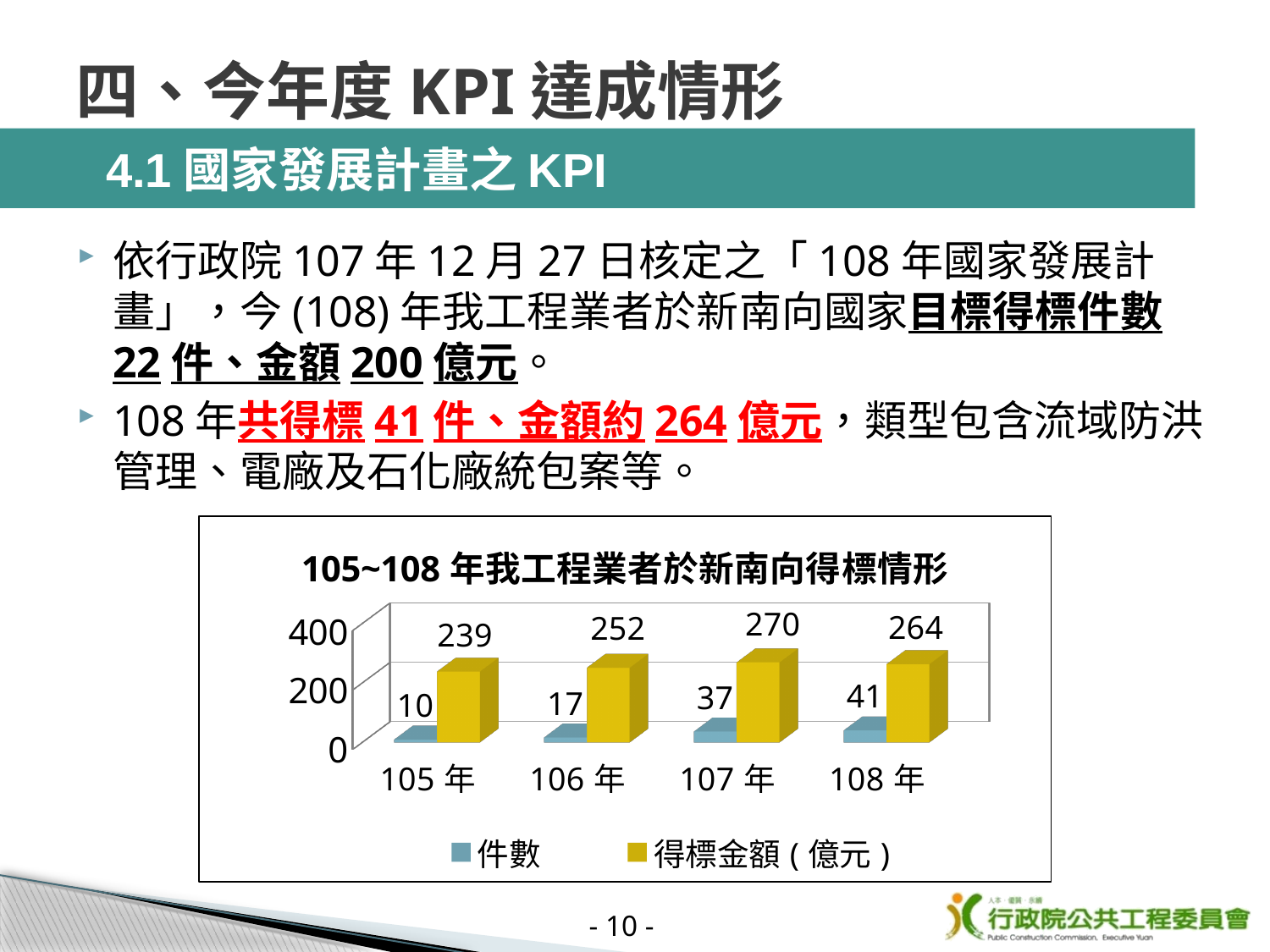
What is the difference in 得標金額 (億元) between 107 年 and 108 年? 6 Which is larger, the 得標金額 (億元) for 106 年 or for 105 年? 106 年 How many years are shown on the x axis of the chart? 4 What is the 件數 value for 106 年? 17 How many series does the chart legend list? 2 Which year has the highest 得標金額 (億元)? 107 年 What is the 得標金額 (億元) value for 107 年? 270 What is the difference in 件數 between 108 年 and 105 年? 31 Which year has the lowest 件數? 105 年 What kind of chart is shown on the slide? bar chart Does the 件數 series rise or fall from 105 年 to 108 年? rise Is the 得標金額 (億元) value for 108 年 greater or less than 200? greater